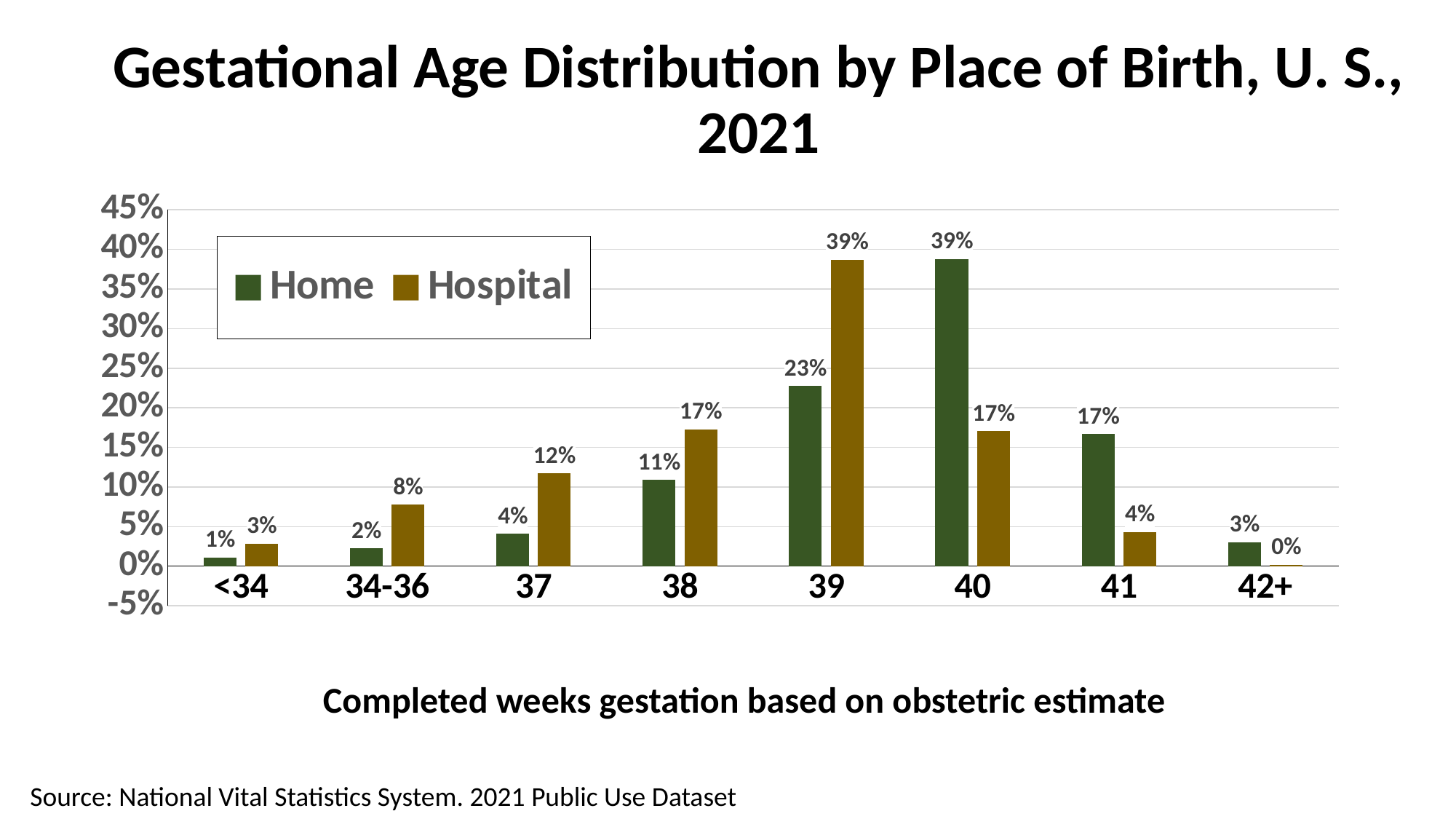
How many series does the legend list? 2 Which gestational age category has the highest Hospital value? 39 What is the x-axis title of the chart? Completed weeks gestation based on obstetric estimate What is the Home value for 39 weeks? 23% Which gestational age category has the highest Home value? 40 What is the Hospital value for 42+ weeks? 0% What is the Hospital value for 38 weeks? 17% How many gestational age categories are shown on the x axis? 8 What is the difference between the Hospital and Home values for 37 weeks? 8% Which is larger at 41 weeks, the Home value or the Hospital value? Home Which gestational age category has the lowest Home value? <34 What kind of chart is shown on the slide? Bar chart